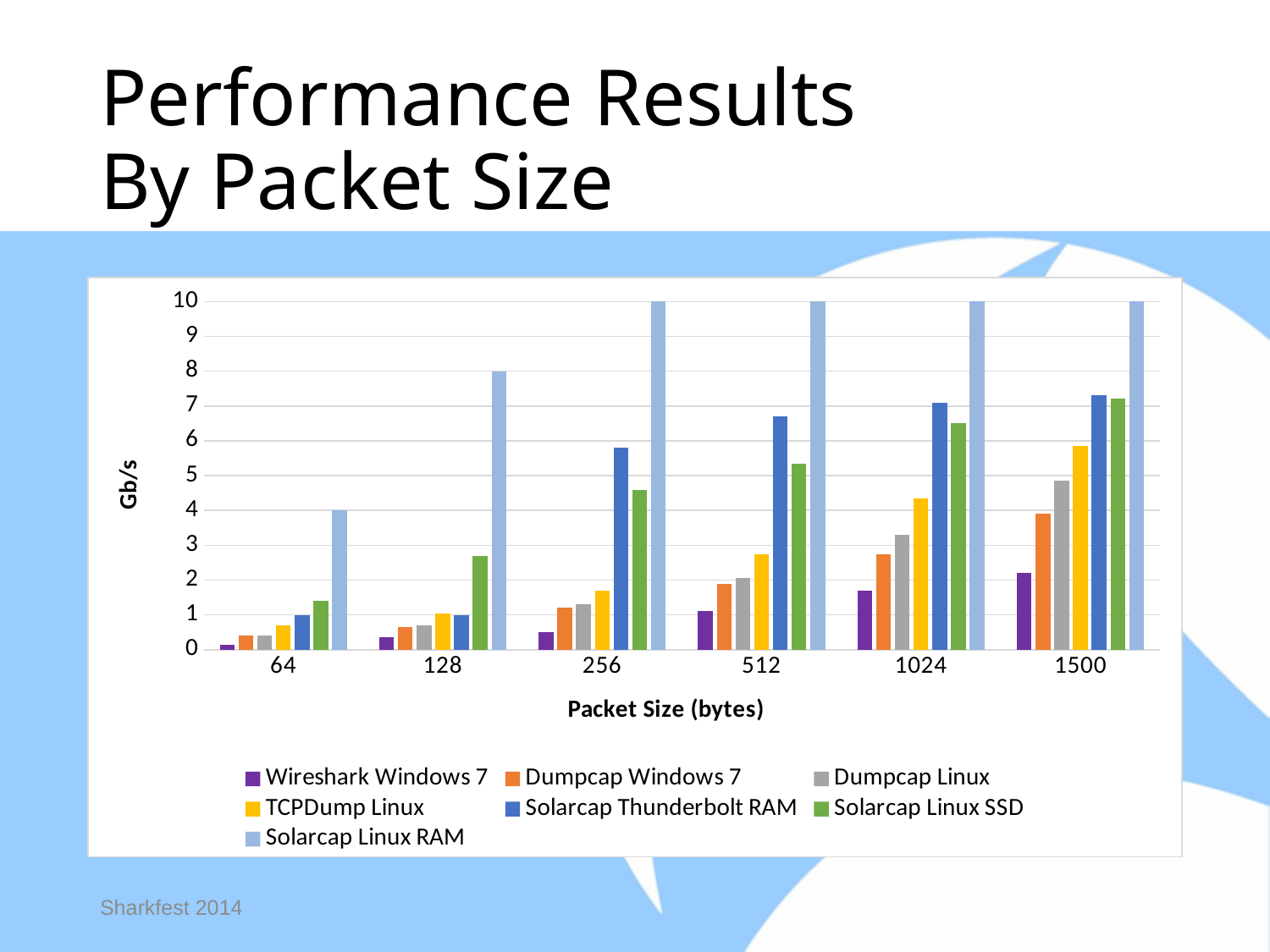
Do the values for Wireshark Windows 7 rise or fall as packet size increases? Rise How many packet sizes are shown on the x axis? 6 Is the value for Solarcap Thunderbolt RAM at packet size 512 greater or less than 6? greater What is the value for Solarcap Linux RAM at packet size 128? 8 What is the value for Solarcap Linux RAM at packet size 64? 4 Which series has the highest value at packet size 64? Solarcap Linux RAM At packet size 1024, which is larger: Solarcap Thunderbolt RAM or Solarcap Linux SSD? Solarcap Thunderbolt RAM Is the value for Dumpcap Linux at packet size 1024 greater or less than 3? greater What type of chart is shown on the slide? Bar chart How many series does the legend list? 7 What is the value for Solarcap Linux RAM at packet size 1500? 10 Which series has the lowest value at packet size 1500? Wireshark Windows 7